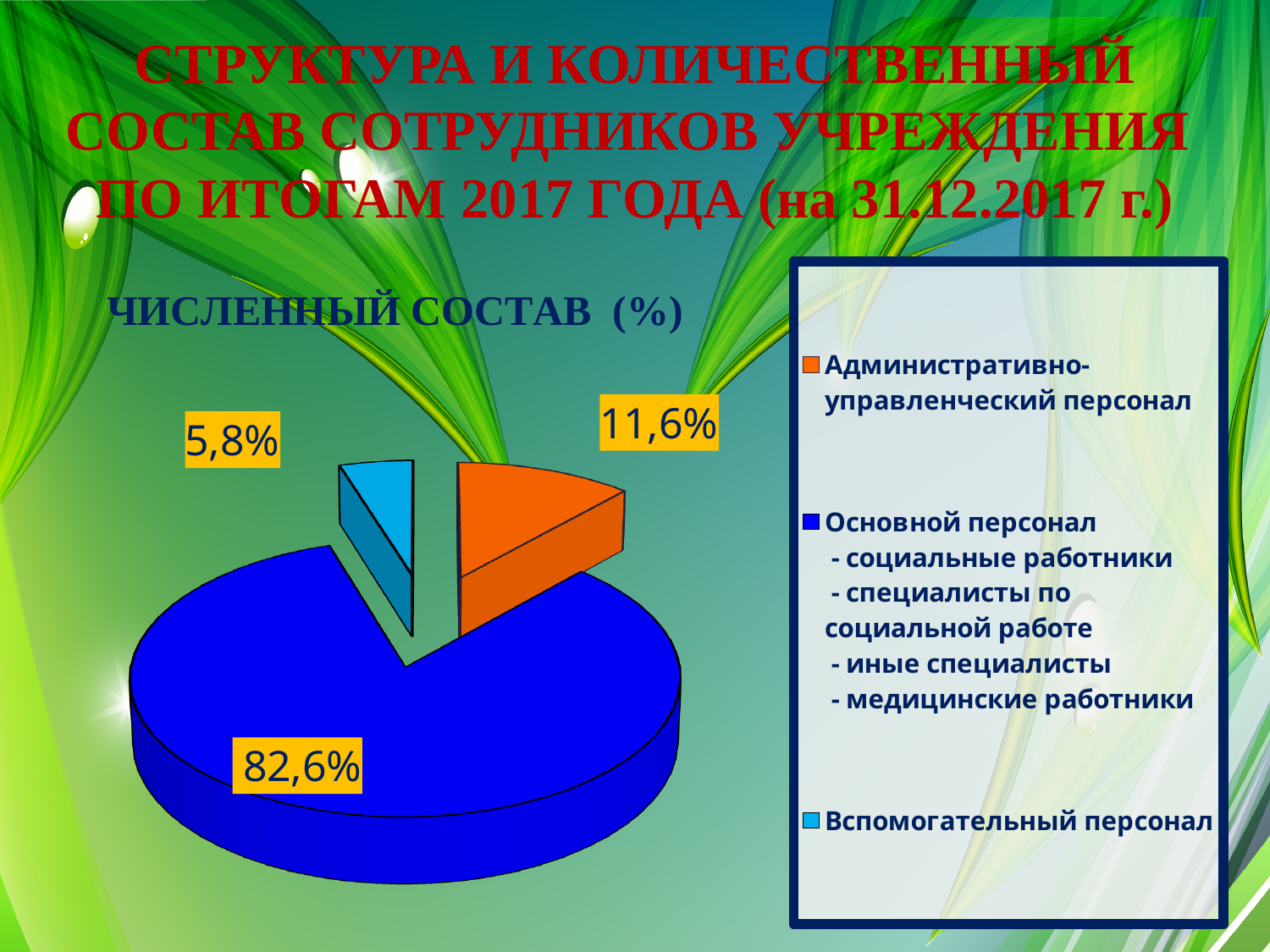
How many entries does the legend list? 3 What percentage of the pie is Основной персонал? 82,6% How many slices does the pie chart have? 3 What value is shown for Вспомогательный персонал? 5,8% Which category has the smallest slice of the pie? Вспомогательный персонал What is the title of the chart? ЧИСЛЕННЫЙ СОСТАВ (%) What value is shown for Административно-управленческий персонал? 11,6% Which is larger: Административно-управленческий персонал or Вспомогательный персонал? Административно-управленческий персонал Which category has the largest slice of the pie? Основной персонал What is the difference between the values for Основной персонал and Административно-управленческий персонал? 71,0% What colour is the slice for Вспомогательный персонал? light blue What kind of chart is shown on the slide? pie chart